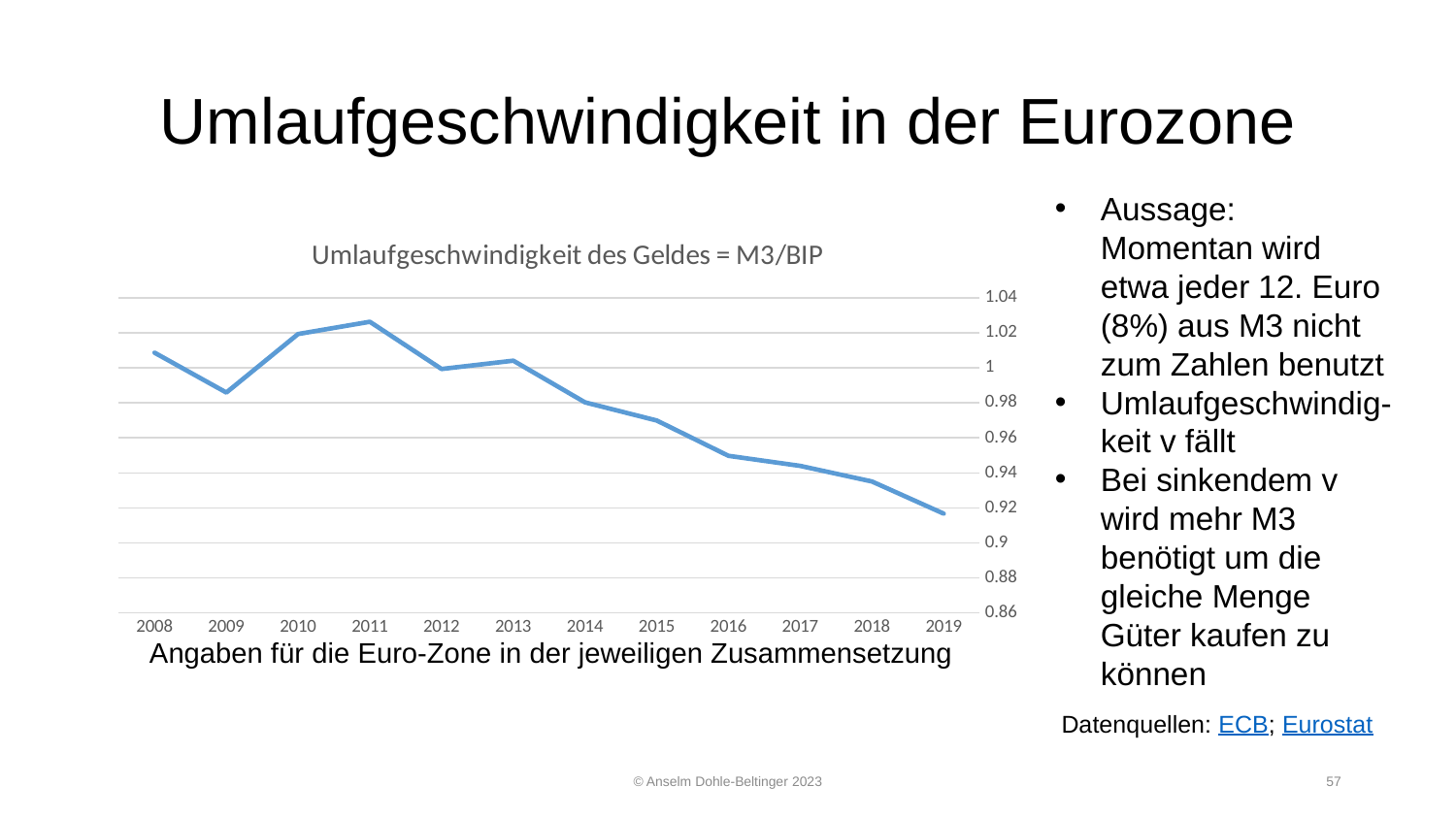
What is the title of the chart? Umlaufgeschwindigkeit des Geldes = M3/BIP Which year has the lowest value in the chart? 2019 Which year has the highest value in the chart? 2011 Is the value for 2009 greater or less than 1? less Is the value for 2011 greater or less than 1? greater Which year has the larger value, 2010 or 2009? 2010 How many years are plotted on the x axis of the chart? 12 Do the values generally rise or fall from 2011 to 2019? fall Is the value for 2019 greater or less than 0.94? less Which year has the larger value, 2012 or 2016? 2012 What kind of chart is shown on the slide? line chart